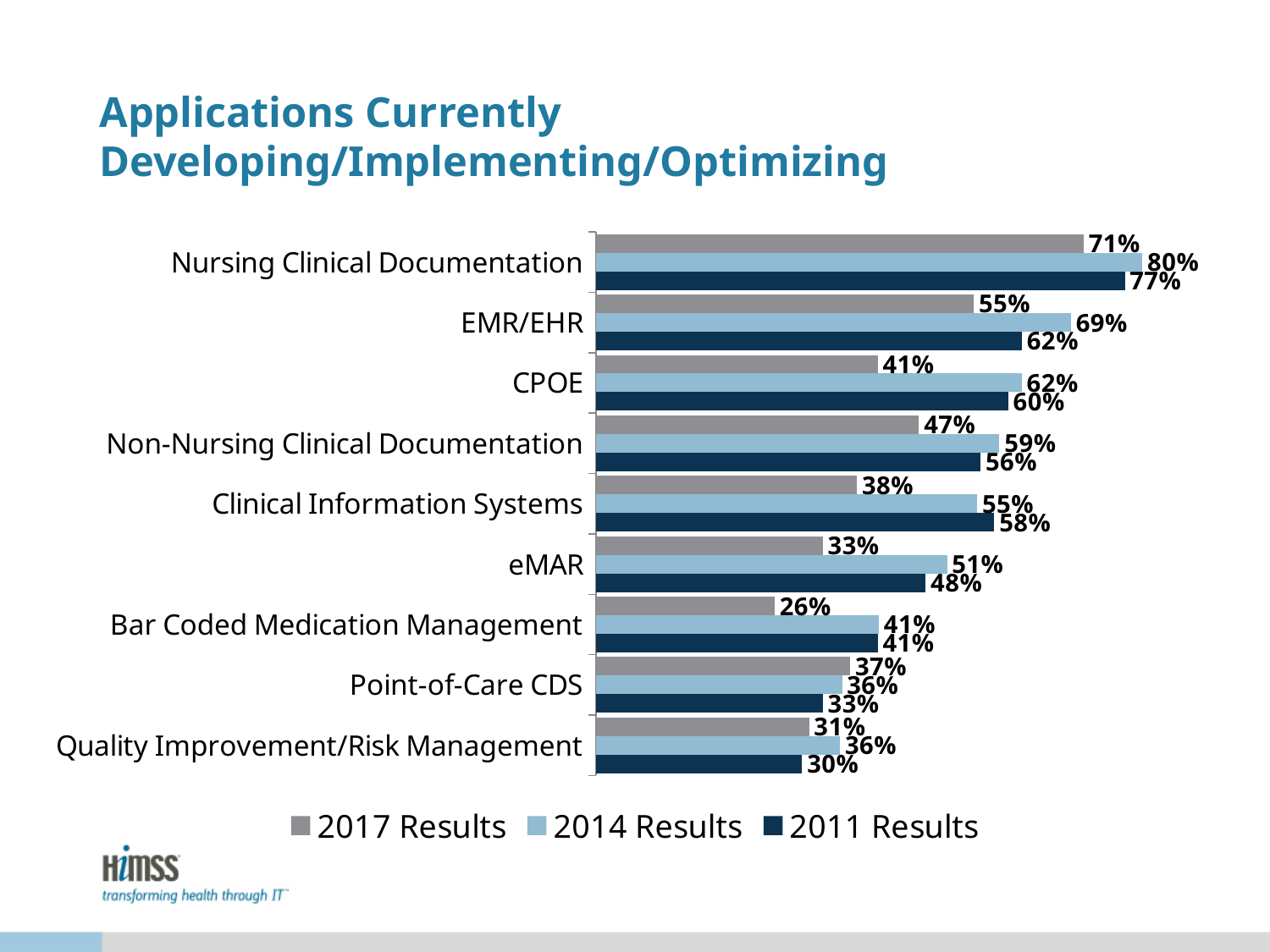
How many applications are shown in the chart? 9 Which application has the highest 2017 Results value? Nursing Clinical Documentation For Clinical Information Systems, which is larger: the 2014 Results value or the 2011 Results value? 2011 Results What is the 2017 Results value for CPOE? 41% What is the 2011 Results value for eMAR? 48% What is the difference between the 2014 Results and 2017 Results values for EMR/EHR? 14% What is the title of the chart? Applications Currently Developing/Implementing/Optimizing What is the 2017 Results value for Bar Coded Medication Management? 26% Which application has the lowest 2011 Results value? Quality Improvement/Risk Management How many series does the legend list? 3 What is the 2014 Results value for Nursing Clinical Documentation? 80% What type of chart is shown on the slide? Bar chart